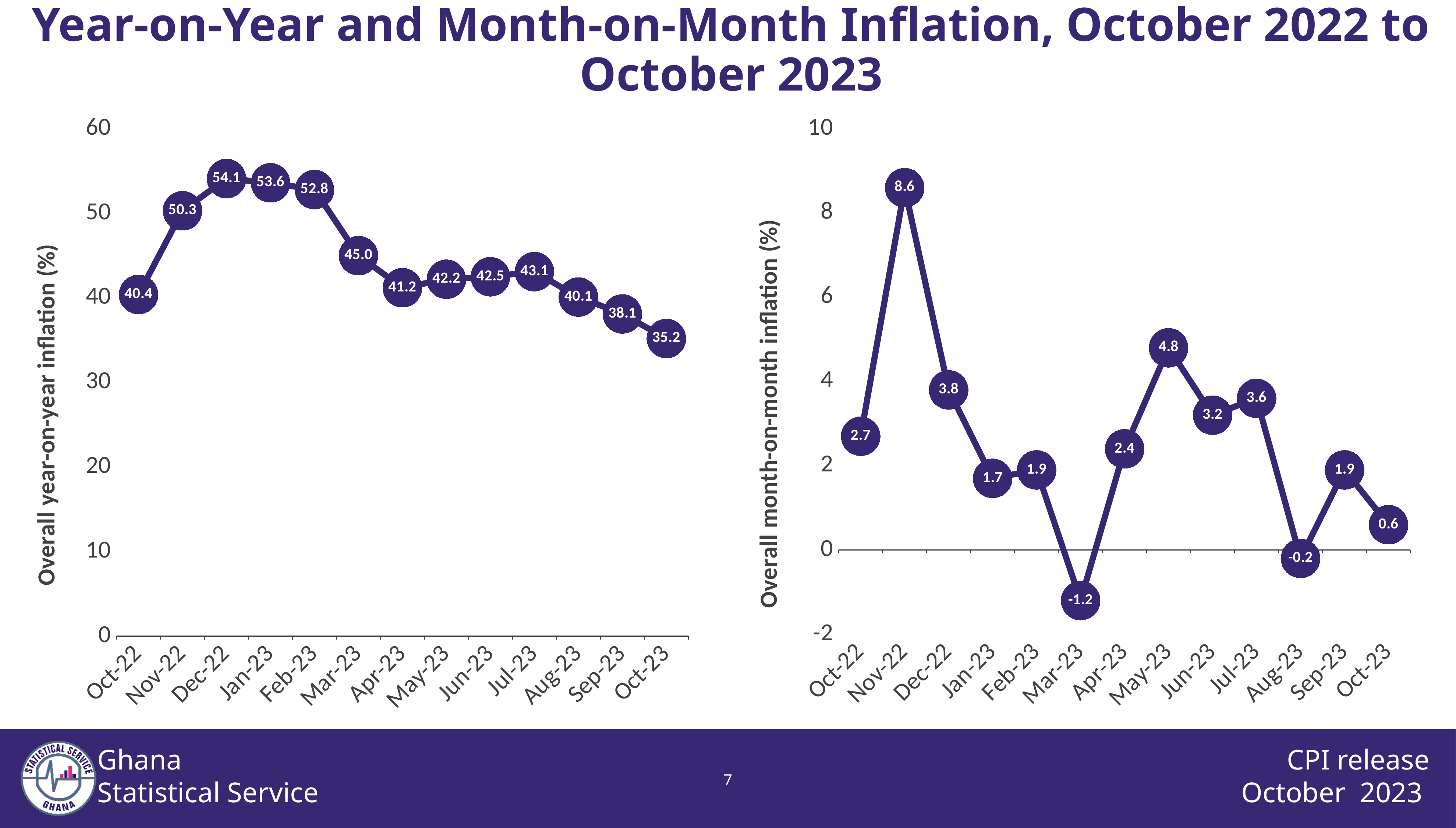
In the left chart (year-on-year inflation), how many data points are plotted? 13 In the right chart (month-on-month inflation), which month has the lowest value? Mar-23 In the right chart (month-on-month inflation), which is larger, the value for May-23 or the value for Jul-23? May-23 What type of chart is the left chart? Line chart In the left chart (year-on-year inflation), what is the difference between the Jan-23 value and the Oct-23 value? 18.4 In the left chart (year-on-year inflation), which month has the lowest value? Oct-23 In the right chart (month-on-month inflation), what is the difference between the Nov-22 value and the Dec-22 value? 4.8 In the left chart (year-on-year inflation), what is the value for Jan-23? 53.6 In the left chart (year-on-year inflation), which month has the highest value? Dec-22 In the left chart (year-on-year inflation), what is the value for Oct-23? 35.2 In the right chart (month-on-month inflation), what is the value for Nov-22? 8.6 In the right chart (month-on-month inflation), what is the value for Mar-23? -1.2